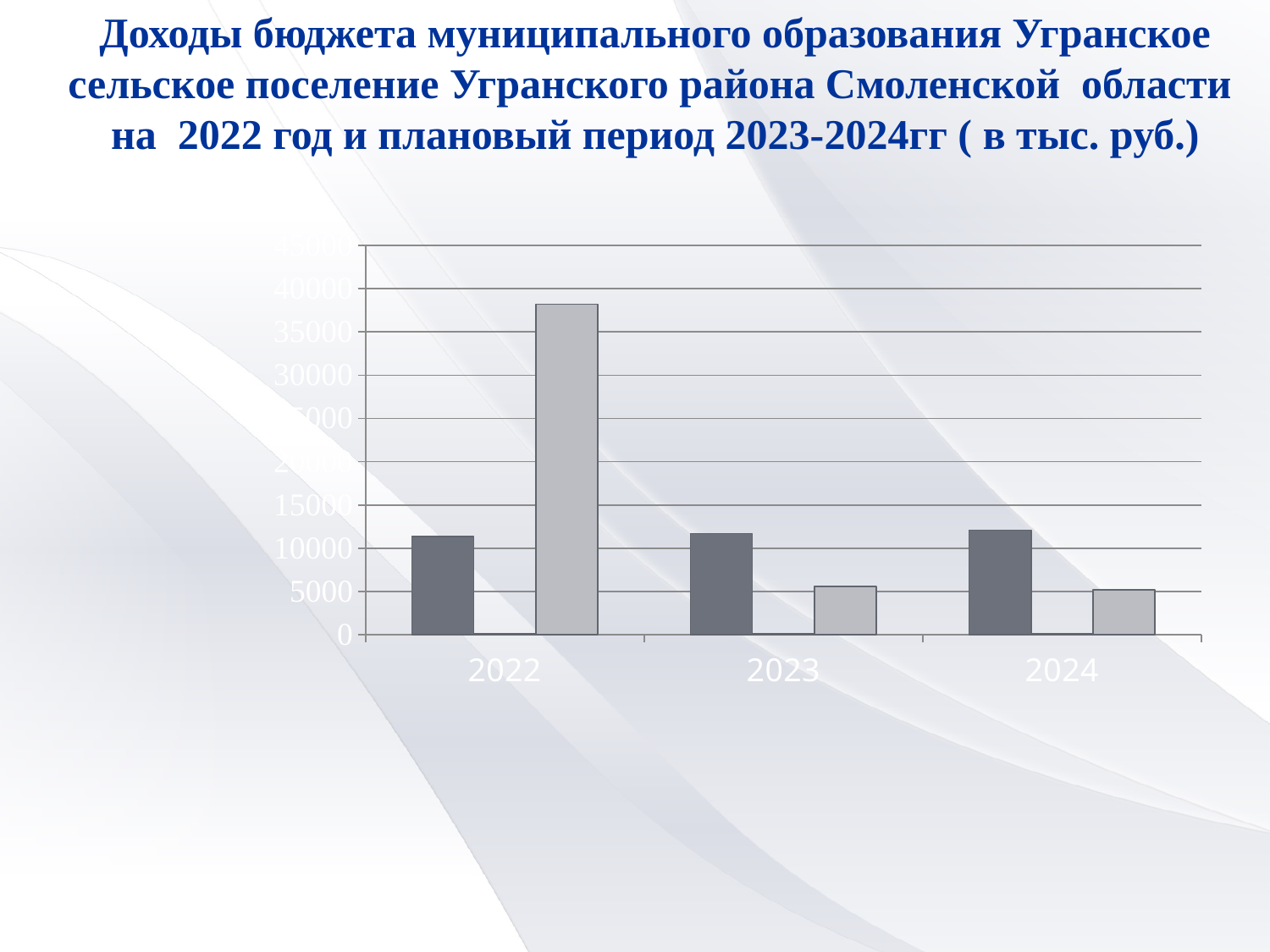
What kind of chart is shown on the slide? bar chart Which bar is the tallest in the chart? the lighter bar for 2022 Is the value of the lighter bar for 2023 greater or less than 10000? less How many categories (years) are shown on the x axis of the chart? 3 Is the value of the darker bar for 2024 greater or less than 10000? greater Is the value of the lighter bar for 2022 greater or less than 35000? greater Which years are shown on the x axis of the chart? 2022, 2023, 2024 In what units are the budget revenues given according to the slide title? тыс. руб. Do the values of the lighter bars rise or fall from 2022 to 2024? fall Which is larger: the lighter bar for 2022 or the lighter bar for 2023? the lighter bar for 2022